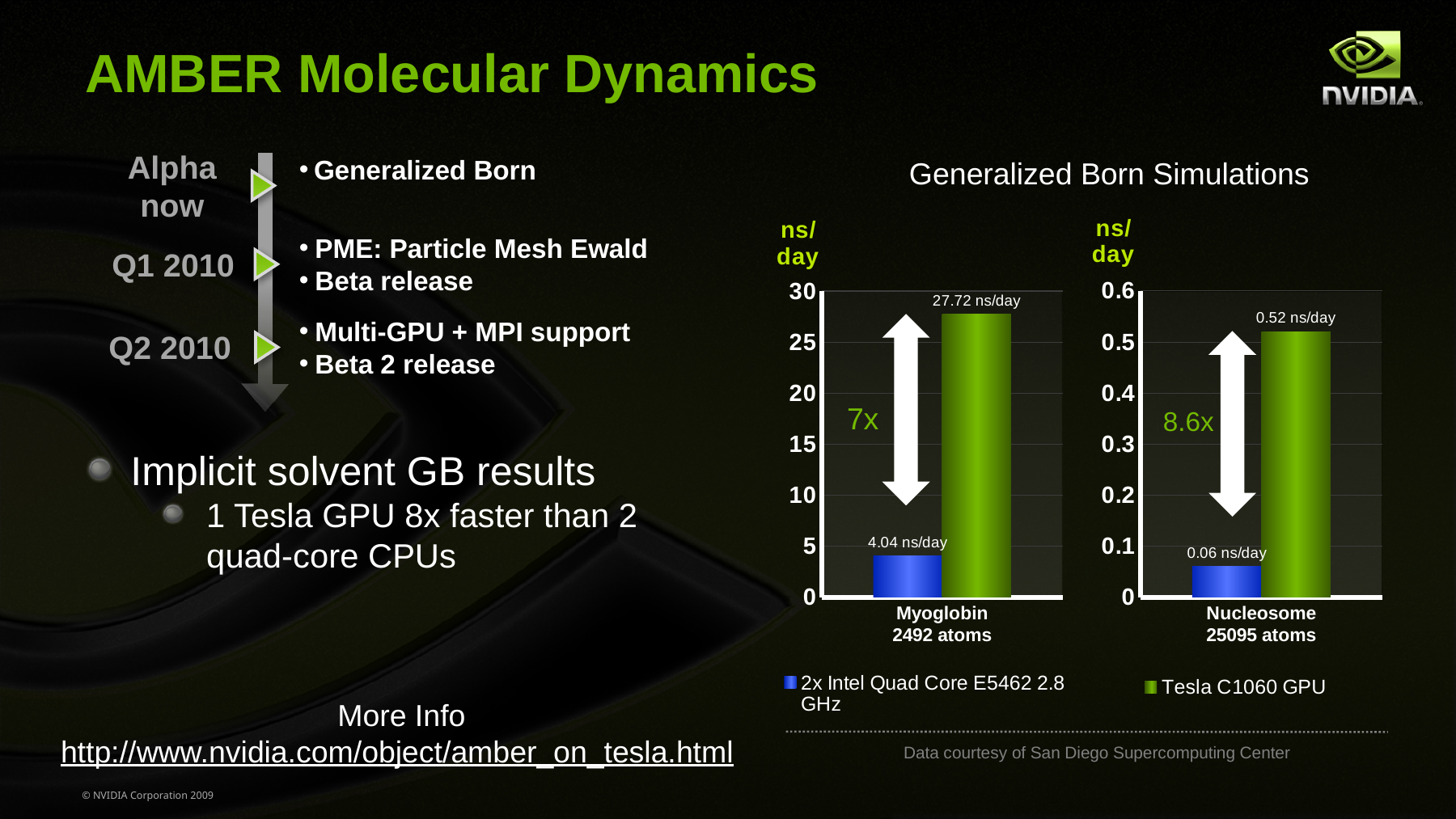
In the Nucleosome chart, what is the value for 2x Intel Quad Core E5462 2.8 GHz? 0.06 ns/day In the Nucleosome chart, is the value for 2x Intel Quad Core E5462 2.8 GHz greater or less than 0.1? less In the Myoglobin chart, what is the value for 2x Intel Quad Core E5462 2.8 GHz? 4.04 ns/day How many series does the legend list for the Generalized Born Simulations charts? 2 In the Myoglobin chart, which series has the higher value? Tesla C1060 GPU What kind of chart is the Myoglobin chart? bar chart In the Nucleosome chart, what is the value for the Tesla C1060 GPU? 0.52 ns/day In the Myoglobin chart, what is the value for the Tesla C1060 GPU? 27.72 ns/day In the Nucleosome chart, which series has the lower value? 2x Intel Quad Core E5462 2.8 GHz In the Nucleosome chart, what is the difference between the Tesla C1060 GPU value and the 2x Intel Quad Core E5462 2.8 GHz value? 0.46 ns/day In the Myoglobin chart, what is the difference between the Tesla C1060 GPU value and the 2x Intel Quad Core E5462 2.8 GHz value? 23.68 ns/day In the Myoglobin chart, is the value for the Tesla C1060 GPU greater or less than 25? greater